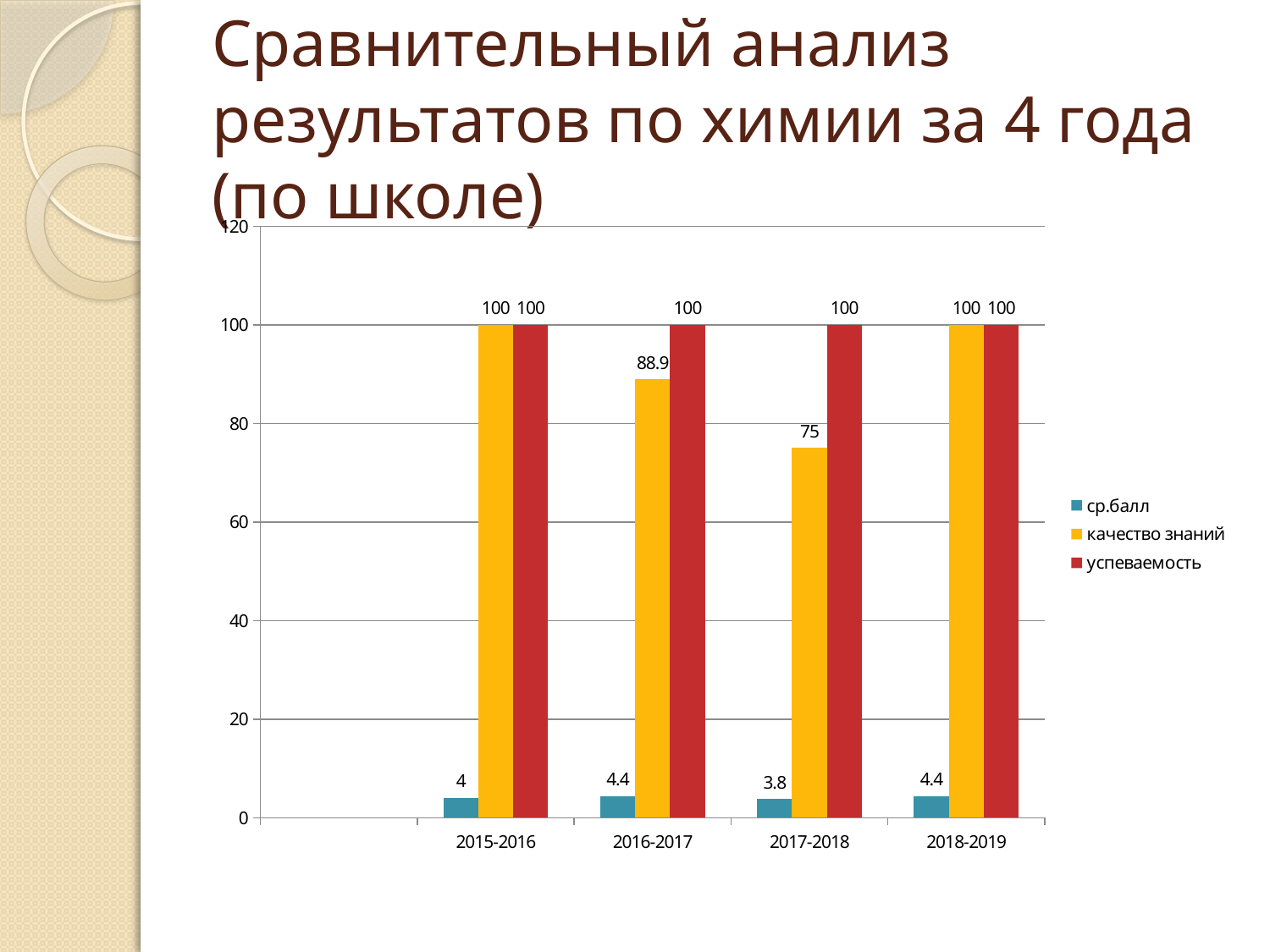
What is the value of успеваемость for 2018-2019? 100 What is the value of качество знаний for 2017-2018? 75 How many year categories are shown on the x axis? 4 In which year is ср.балл the lowest? 2017-2018 What is the value of ср.балл for 2017-2018? 3.8 What is the difference between качество знаний in 2015-2016 and in 2017-2018? 25 What is the value of качество знаний for 2016-2017? 88.9 How many series does the legend list? 3 What is the difference between ср.балл in 2016-2017 and in 2017-2018? 0.6 In which year is качество знаний the lowest? 2017-2018 Which is larger, качество знаний in 2016-2017 or in 2017-2018? 2016-2017 What kind of chart is shown on the slide? Bar chart